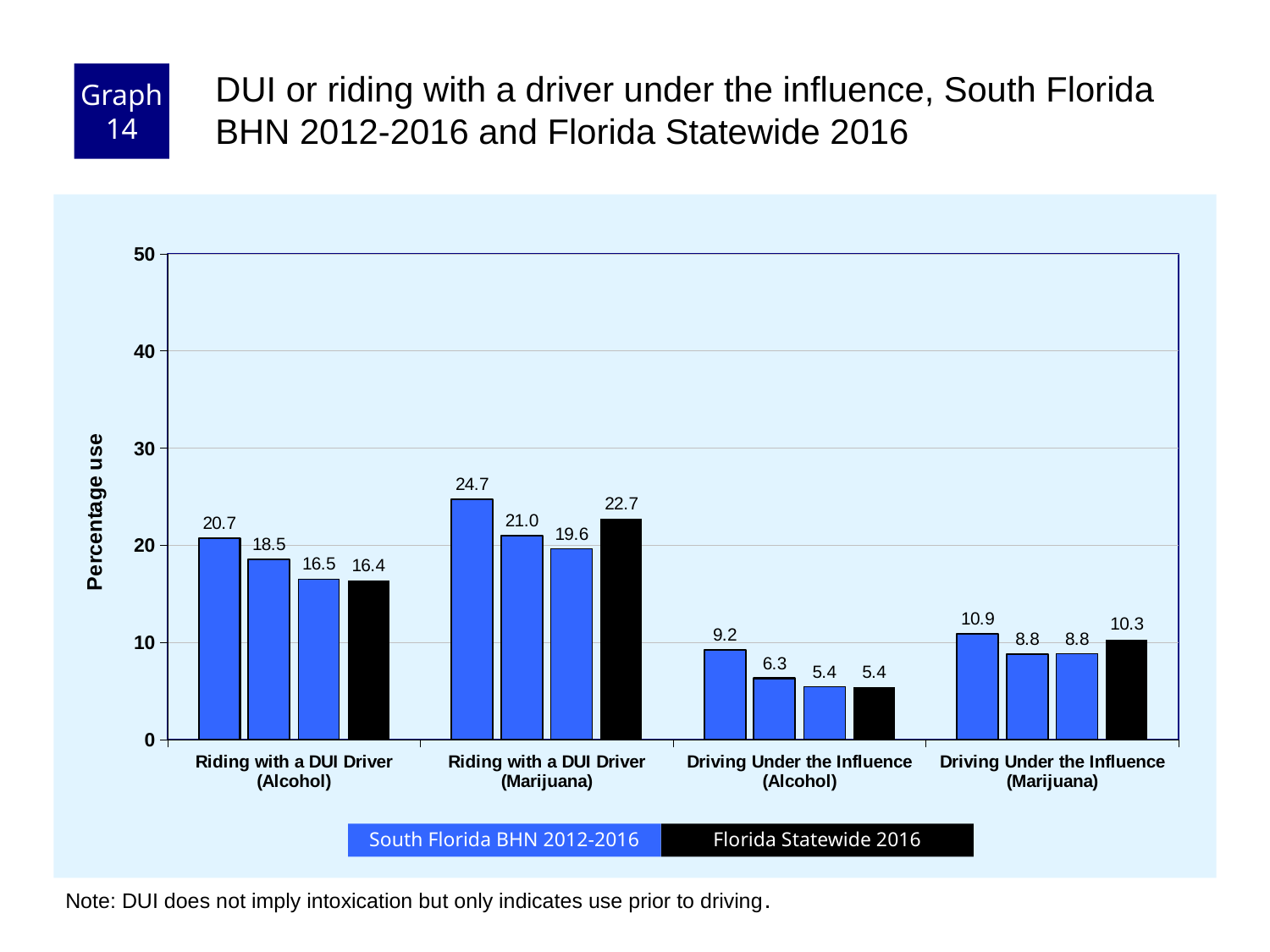
What is the title of the y axis? Percentage use Which category contains the tallest bar in the chart? Riding with a DUI Driver (Marijuana) How many series does the legend list? 2 What kind of chart is shown on the slide? bar chart What is the Florida Statewide 2016 value for Driving Under the Influence (Alcohol)? 5.4 How many categories are shown on the x axis? 4 Is the Florida Statewide 2016 value for Riding with a DUI Driver (Alcohol) greater or less than 20? less What is the value of the leftmost bar in the Riding with a DUI Driver (Alcohol) group? 20.7 Which category has the lowest Florida Statewide 2016 value? Driving Under the Influence (Alcohol) Which is larger, the Florida Statewide 2016 value for Driving Under the Influence (Marijuana) or for Driving Under the Influence (Alcohol)? Driving Under the Influence (Marijuana) What is the Florida Statewide 2016 value for Riding with a DUI Driver (Marijuana)? 22.7 What is the difference between the Florida Statewide 2016 values for Riding with a DUI Driver (Marijuana) and Riding with a DUI Driver (Alcohol)? 6.3